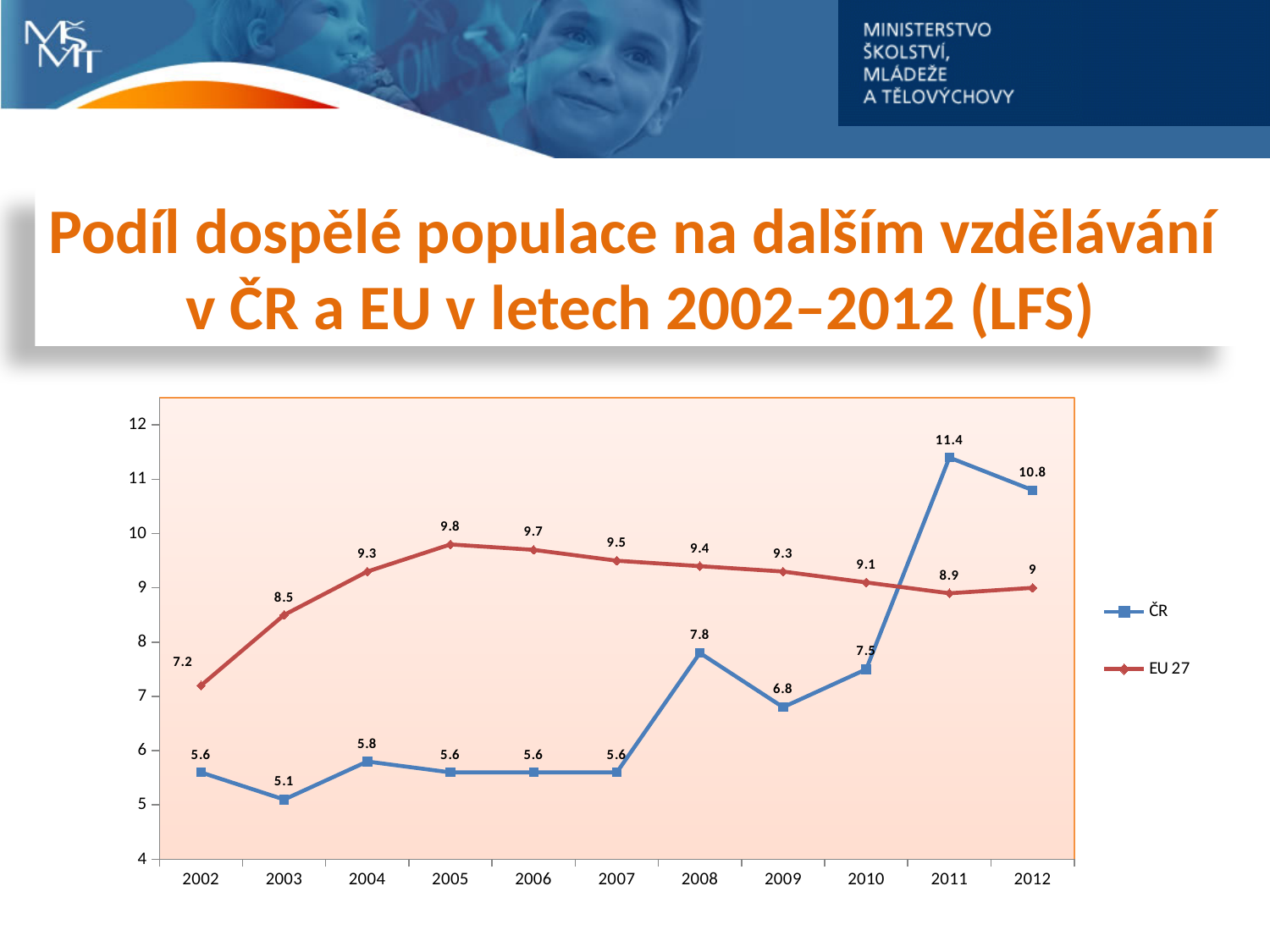
How many years are shown on the x axis? 11 In which year is the ČR value lowest? 2003 What is the value for EU 27 in 2005? 9.8 What is the value for ČR in 2003? 5.1 Which series has the larger value in 2010, ČR or EU 27? EU 27 In which year is the EU 27 value highest? 2005 What is the difference between the ČR and EU 27 values in 2012? 1.8 What type of chart is shown on the slide? line chart What is the value for ČR in 2011? 11.4 Which series is drawn in red? EU 27 How many series does the legend list? 2 Does the EU 27 series rise or fall from 2005 to 2011? fall